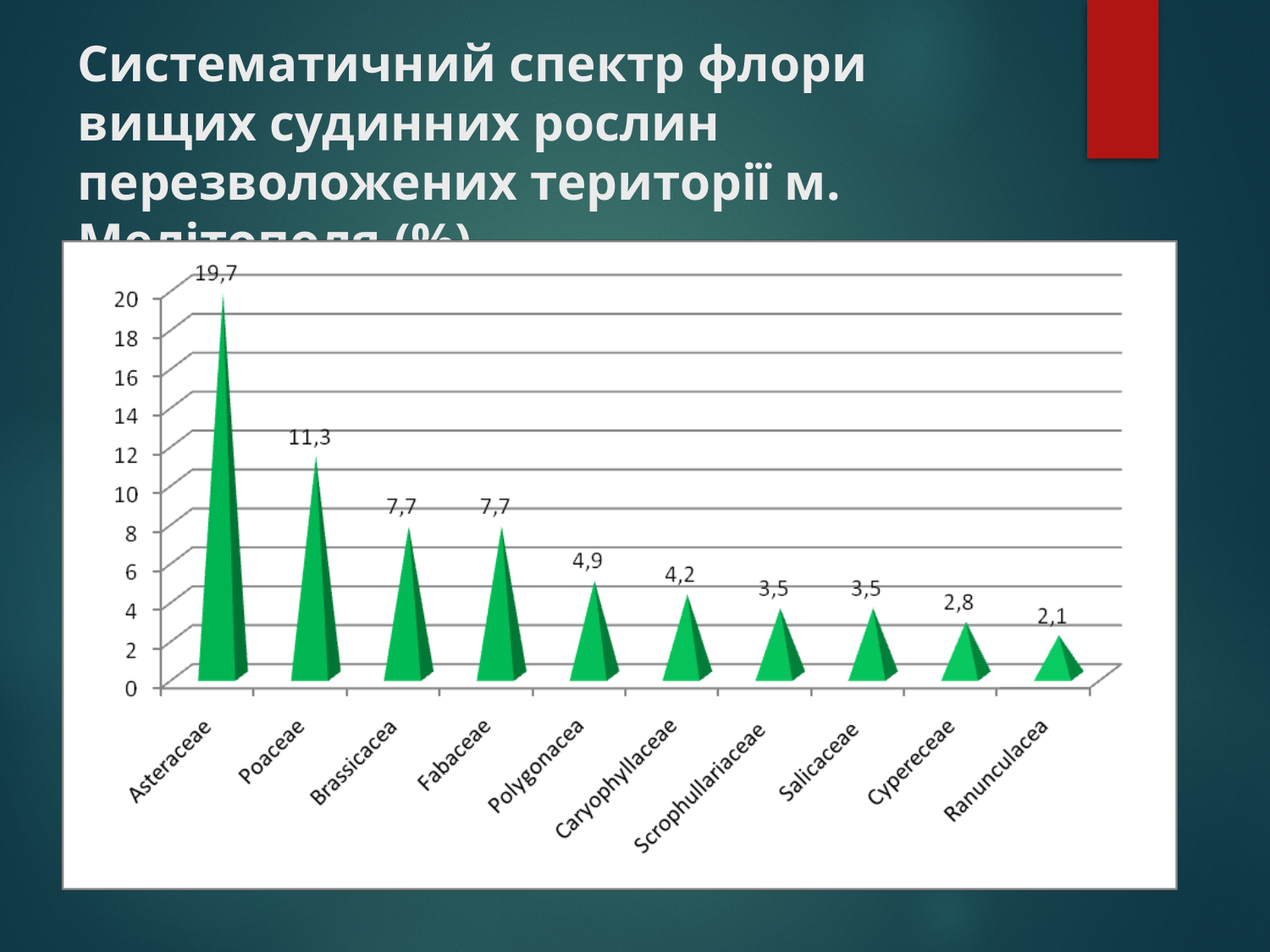
Which family has the highest value? Asteraceae Which is larger, the value for Poaceae or the value for Fabaceae? Poaceae Which family has the lowest value? Ranunculacea What is the difference between the values for Caryophyllaceae and Ranunculacea? 2,1 What is the difference between the values for Asteraceae and Poaceae? 8,4 What is the value for Poaceae? 11,3 What is the value for Cypereceae? 2,8 What is the value for Asteraceae? 19,7 Is the value for Brassicacea greater or less than 10? less What is the value for Polygonacea? 4,9 How many families are shown on the x axis? 10 What kind of chart is shown on the slide? bar chart